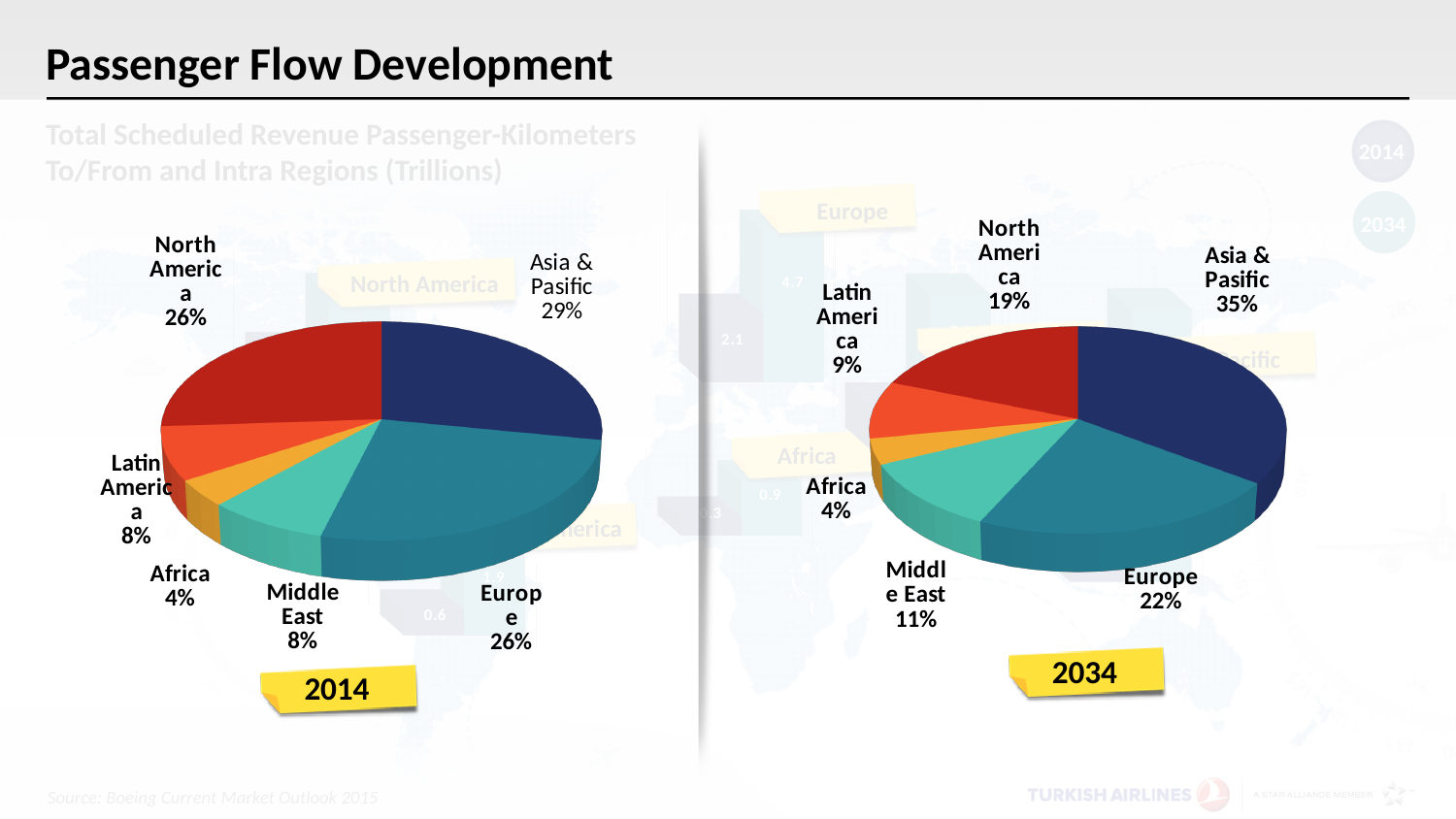
In the 2034 pie chart, which region has the smallest share? Africa In the 2014 pie chart, what is the difference between the Europe share and the Middle East share? 18% In the 2014 pie chart, what share does Asia & Pacific have? 29% How many regions are shown in the 2014 pie chart? 6 In the 2034 pie chart, which is larger, the share for Latin America or the share for Middle East? Middle East What type of chart is the 2034 chart? Pie chart Comparing the 2014 and 2034 pie charts, does the North America share rise or fall? Fall In the 2034 pie chart, what is the difference between the Asia & Pacific share and the North America share? 16% In the 2034 pie chart, what share does Middle East have? 11% In the 2034 pie chart, what share does Europe have? 22% In the 2014 pie chart, which region has the largest share? Asia & Pasific What is the title of the slide? Passenger Flow Development